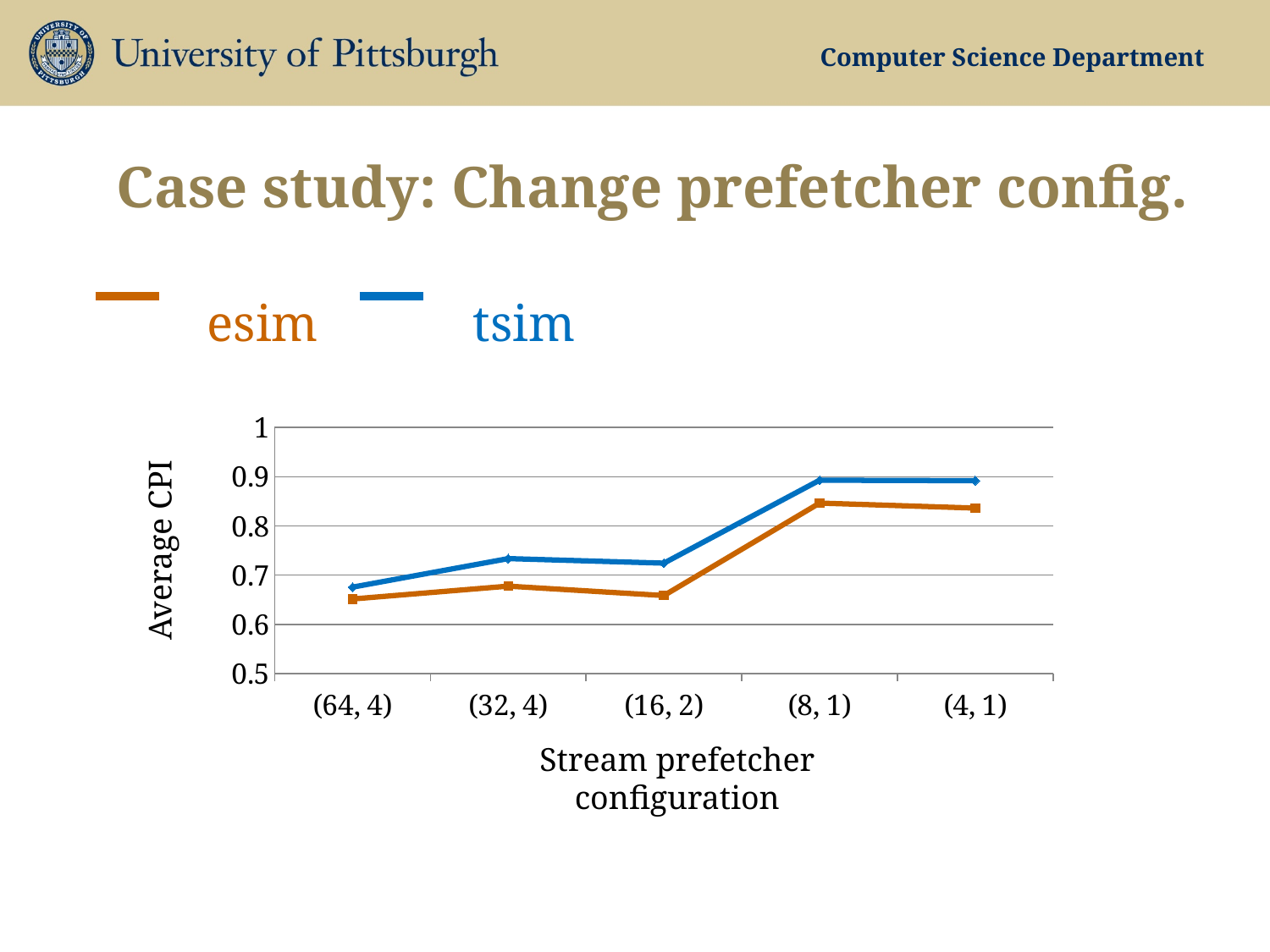
What kind of chart is shown on the slide? line chart Is the esim value for configuration (4, 1) greater or less than 0.9? less What colour is the esim line? orange Is the esim value for configuration (64, 4) greater or less than 0.7? less How many stream prefetcher configurations are plotted along the x axis? 5 Is the tsim value for configuration (8, 1) greater or less than 0.8? greater What is the label of the y axis? Average CPI Between configurations (16, 2) and (8, 1), does the esim line rise or fall? rise At configuration (16, 2), which series has the higher average CPI, esim or tsim? tsim For which configuration is the tsim average CPI lowest? (64, 4) How many series does the legend list? 2